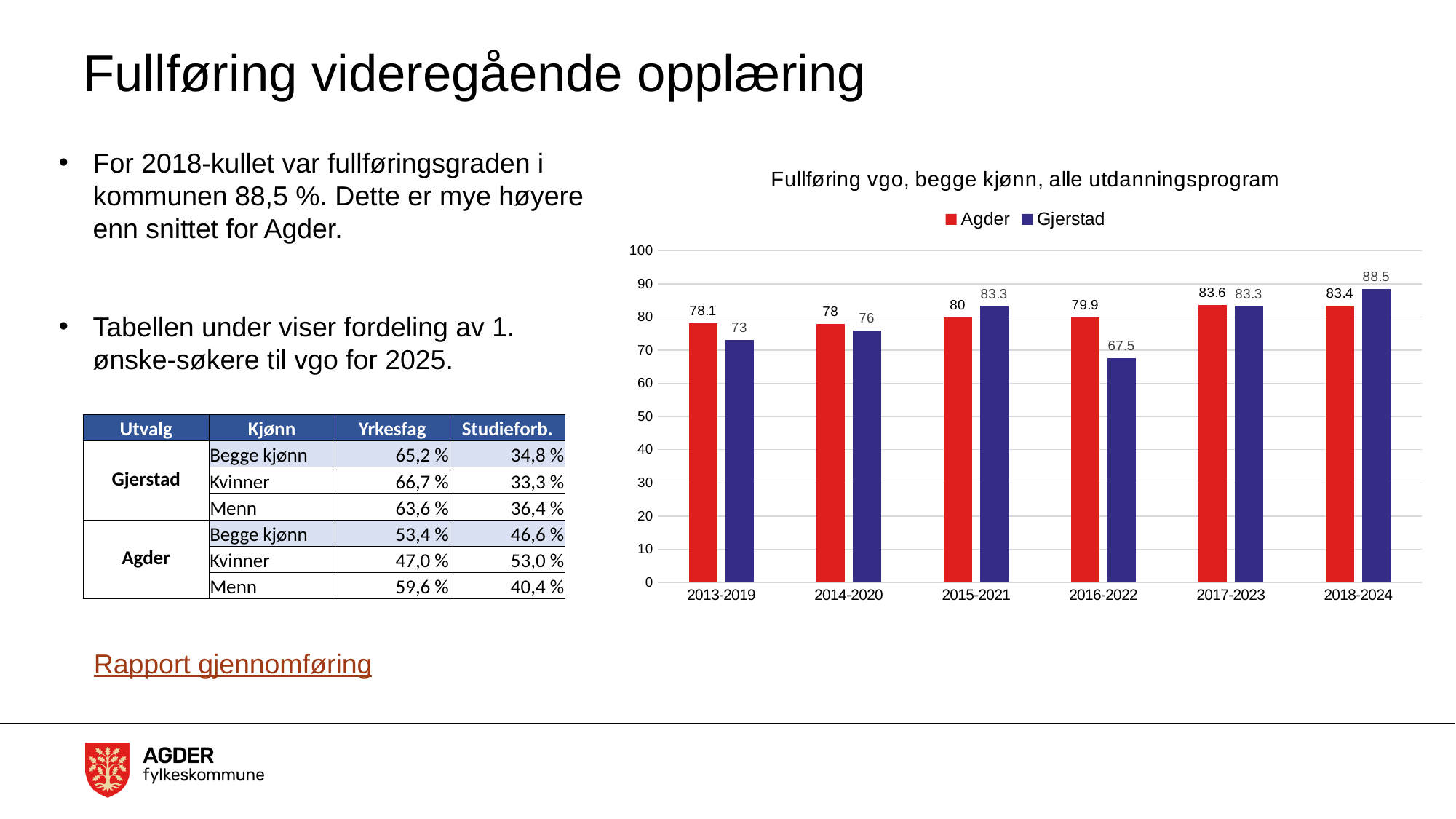
How many series does the legend list? 2 Which period has the highest value for Agder? 2017-2023 What is the difference between Gjerstad and Agder in 2016-2022? 12.4 How many periods are shown on the x axis? 6 Which period has the lowest value for Gjerstad? 2016-2022 Is the value for Gjerstad in 2014-2020 greater or less than 80? less What is the title of the chart? Fullføring vgo, begge kjønn, alle utdanningsprogram Which is larger in 2015-2021, Agder or Gjerstad? Gjerstad What is the value for Gjerstad in 2018-2024? 88.5 What is the value for Gjerstad in 2013-2019? 73 What kind of chart is shown? bar chart What is the value for Agder in 2016-2022? 79.9